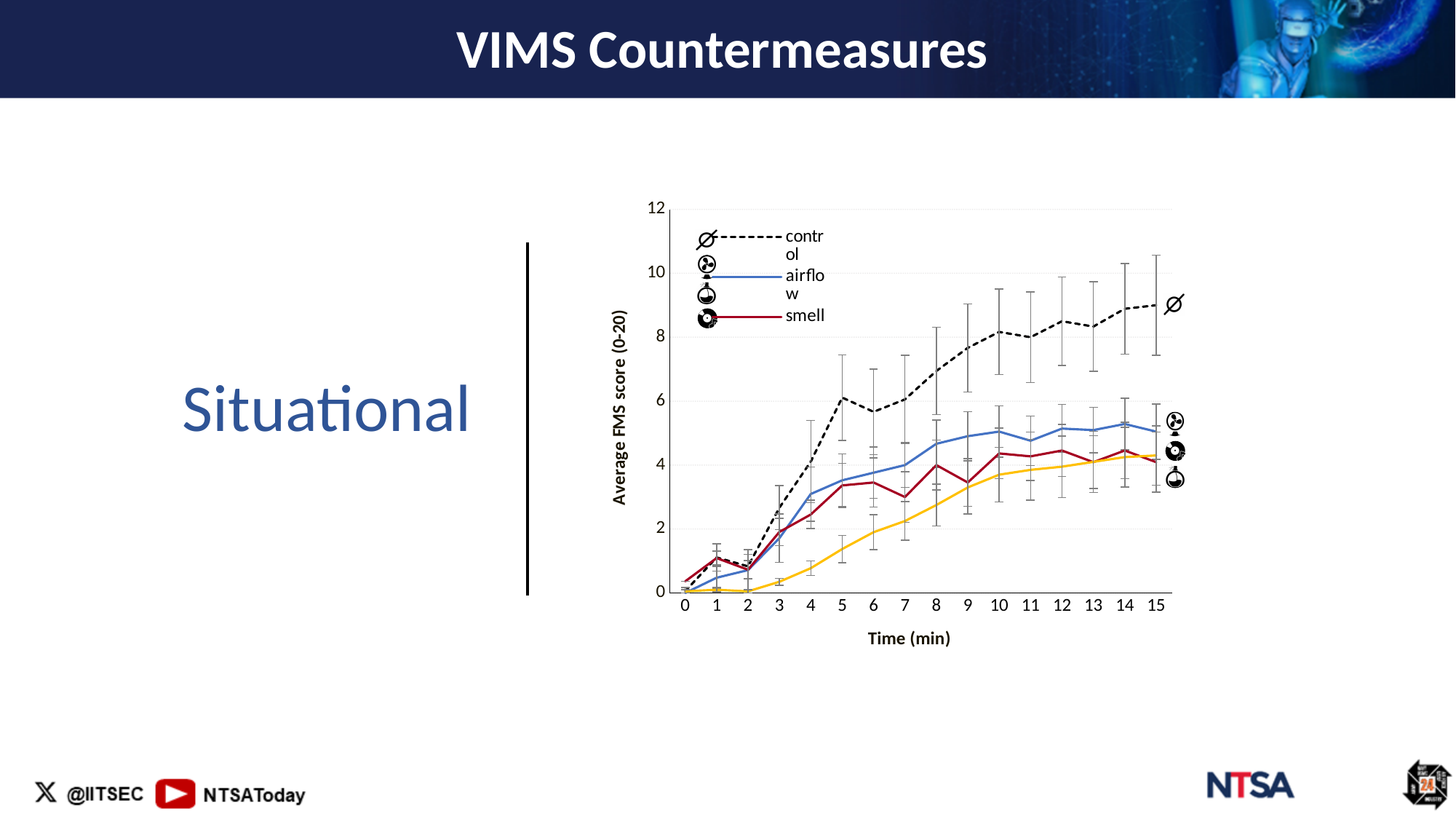
Is the value for control at 5 minutes greater or less than 4? greater Is the value for control at 15 minutes greater or less than 8? greater How many time points are marked on the x axis of the chart? 16 At 15 minutes, which is larger: the control value or the airflow value? control What is the x-axis title of the chart? Time (min) Which series has the highest value at 15 minutes? control Is the value for smell at 15 minutes greater or less than 6? less What is the y-axis title of the chart? Average FMS score (0-20) Does the control series rise or fall as time increases from 0 to 15 minutes? rise What kind of chart is shown on the slide? line chart How many series does the chart's legend list? 3